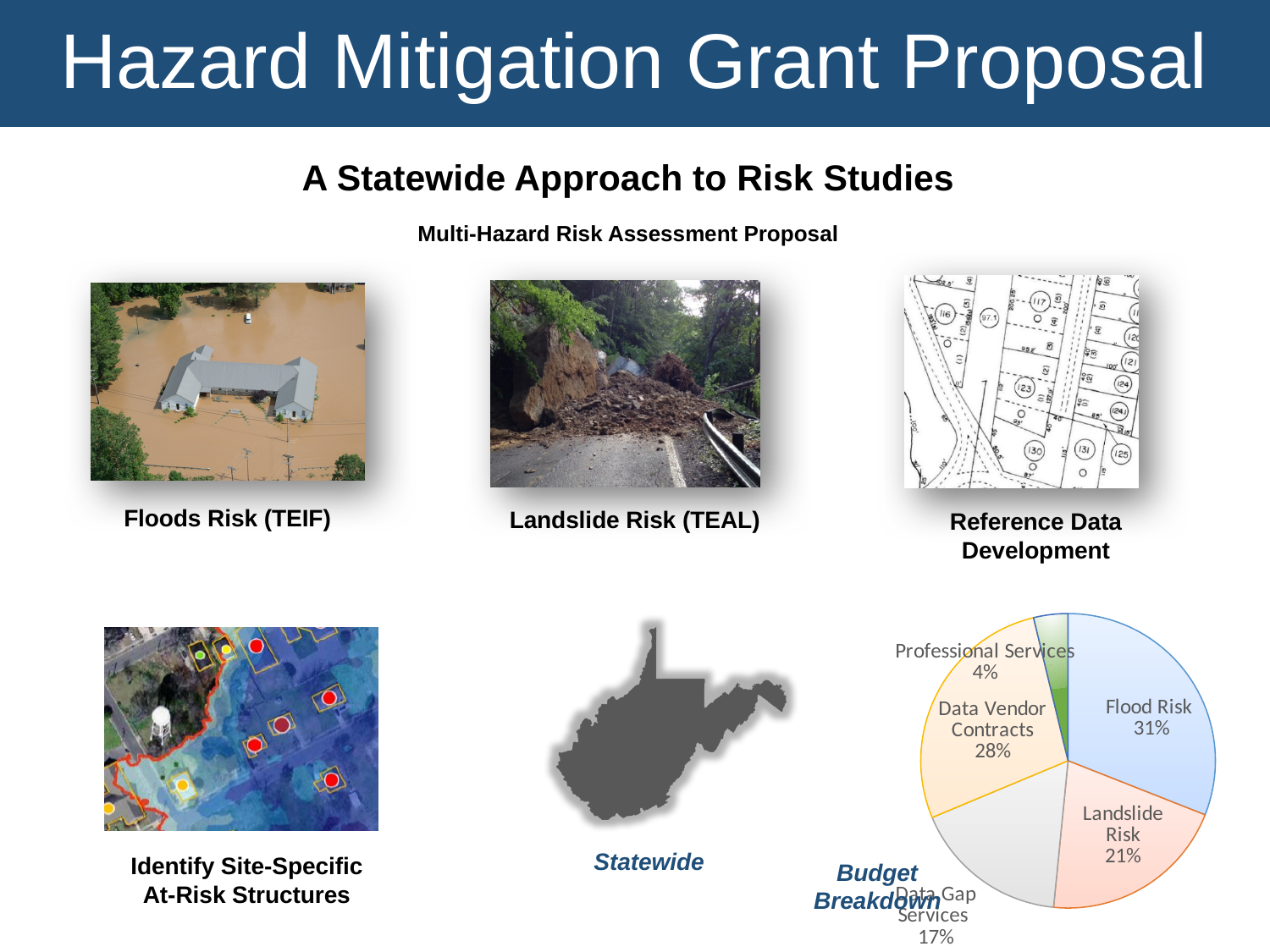
In the Budget Breakdown pie chart, how many slices are there? 5 In the Budget Breakdown pie chart, what share does Flood Risk have? 31% In the Budget Breakdown pie chart, what is the difference in percentage points between Flood Risk and Landslide Risk? 10 What kind of chart is the Budget Breakdown chart? pie chart In the Budget Breakdown pie chart, what share does Data Gap Services have? 17% In the Budget Breakdown pie chart, what share does Professional Services have? 4% In the Budget Breakdown pie chart, which is larger, Data Vendor Contracts or Data Gap Services? Data Vendor Contracts In the Budget Breakdown pie chart, which category has the largest share? Flood Risk What is the title of the pie chart on the slide? Budget Breakdown In the Budget Breakdown pie chart, what share does Data Vendor Contracts have? 28% In the Budget Breakdown pie chart, which category has the smallest share? Professional Services In the Budget Breakdown pie chart, what share does Landslide Risk have? 21%